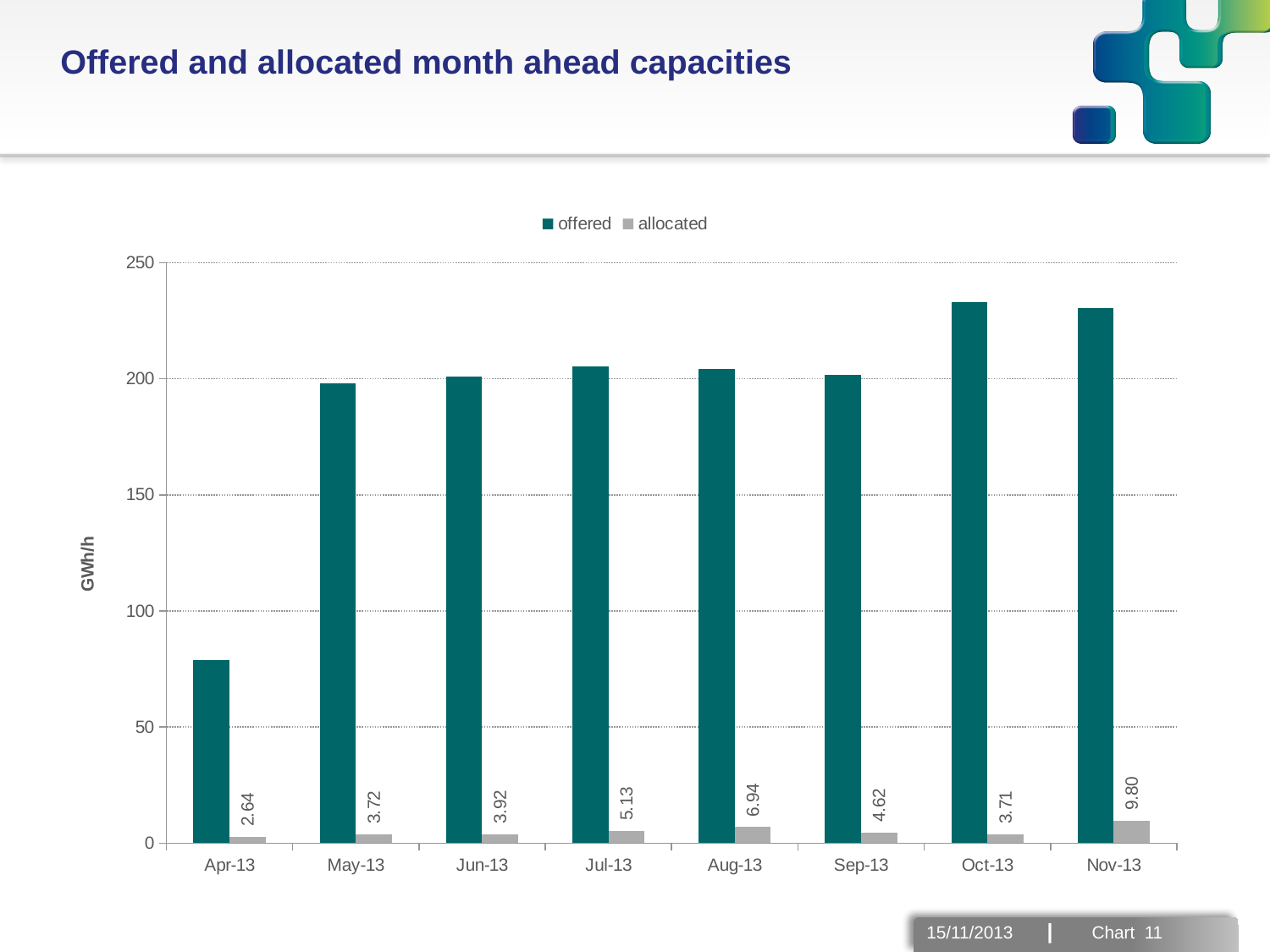
What is the difference between the allocated values for Aug-13 and Sep-13? 2.32 What is the allocated value for Apr-13? 2.64 Is the offered value for Oct-13 greater or less than 200? greater Which month has the highest allocated value? Nov-13 Which is larger, the allocated value for May-13 or for Oct-13? May-13 What kind of chart is shown on the slide? bar chart Which month has the lowest allocated value? Apr-13 Is the offered value for Apr-13 greater or less than 100? less What is the allocated value for Nov-13? 9.80 How many series does the legend list? 2 What is the allocated value for Jul-13? 5.13 How many months are shown on the x axis? 8